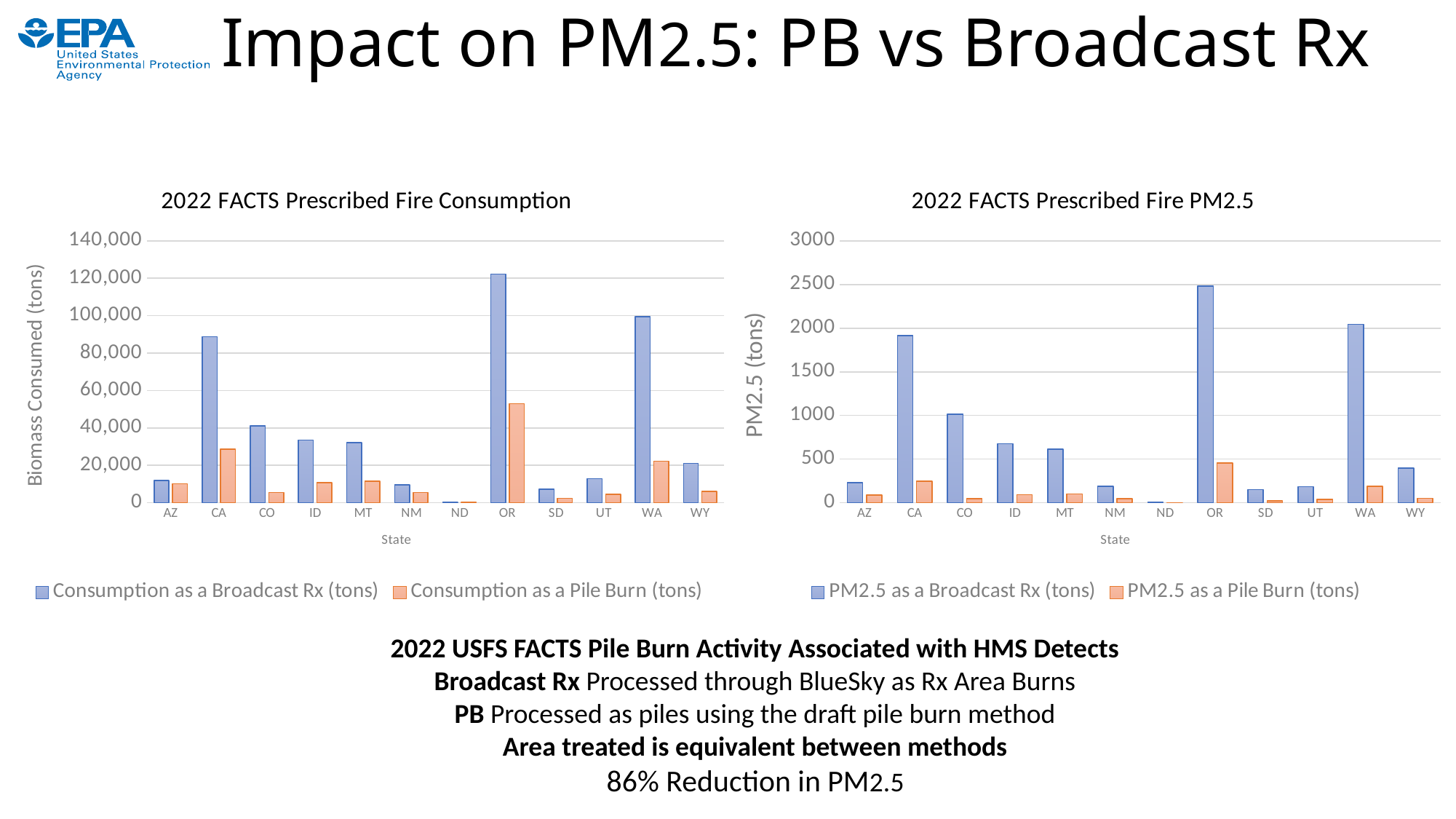
In the "2022 FACTS Prescribed Fire PM2.5" chart, which state has the highest PM2.5 as a Broadcast Rx (tons)? OR In the "2022 FACTS Prescribed Fire PM2.5" chart, which state has the larger PM2.5 as a Broadcast Rx (tons), CO or ID? CO In the "2022 FACTS Prescribed Fire PM2.5" chart, is the PM2.5 as a Broadcast Rx (tons) for OR greater or less than 2000? greater In the "2022 FACTS Prescribed Fire Consumption" chart, is the Consumption as a Pile Burn (tons) for OR greater or less than 40,000? greater How many states are shown on the x axis of the "2022 FACTS Prescribed Fire PM2.5" chart? 12 In the "2022 FACTS Prescribed Fire Consumption" chart, is the Consumption as a Broadcast Rx (tons) for OR greater or less than 100,000? greater What is the y-axis label of the "2022 FACTS Prescribed Fire PM2.5" chart? PM2.5 (tons) In the "2022 FACTS Prescribed Fire PM2.5" chart, which state has the highest PM2.5 as a Pile Burn (tons)? OR How many series does the legend of the "2022 FACTS Prescribed Fire Consumption" chart list? 2 In the "2022 FACTS Prescribed Fire Consumption" chart, which state has the lowest Consumption as a Broadcast Rx (tons)? ND What type of chart is the "2022 FACTS Prescribed Fire Consumption" chart? bar chart In the "2022 FACTS Prescribed Fire Consumption" chart, which state has the highest Consumption as a Broadcast Rx (tons)? OR